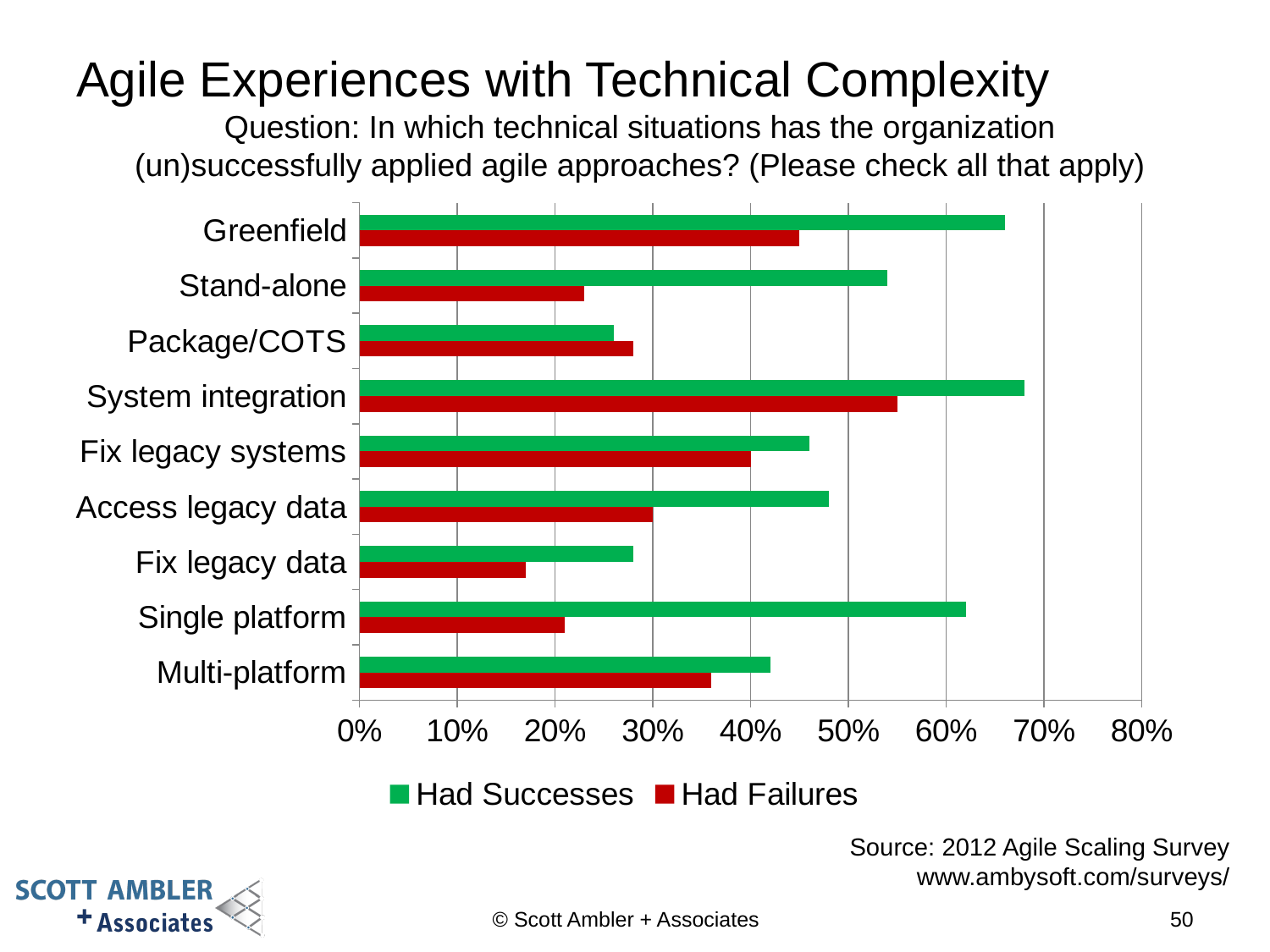
What colour are the Had Failures bars? red How many series does the legend list? 2 Is the Had Failures value for Stand-alone greater or less than 30%? less For Stand-alone, which is larger: Had Successes or Had Failures? Had Successes Is the Had Failures value for System integration greater or less than 50%? greater Which category has the highest value for Had Failures? System integration How many technical situations (categories) are plotted on the chart? 9 What kind of chart is shown on the slide? bar chart Is the Had Successes value for Single platform greater or less than 60%? greater Which is larger: the Had Successes value for Single platform or the Had Successes value for Multi-platform? Single platform Which category has the lowest value for Had Failures? Fix legacy data